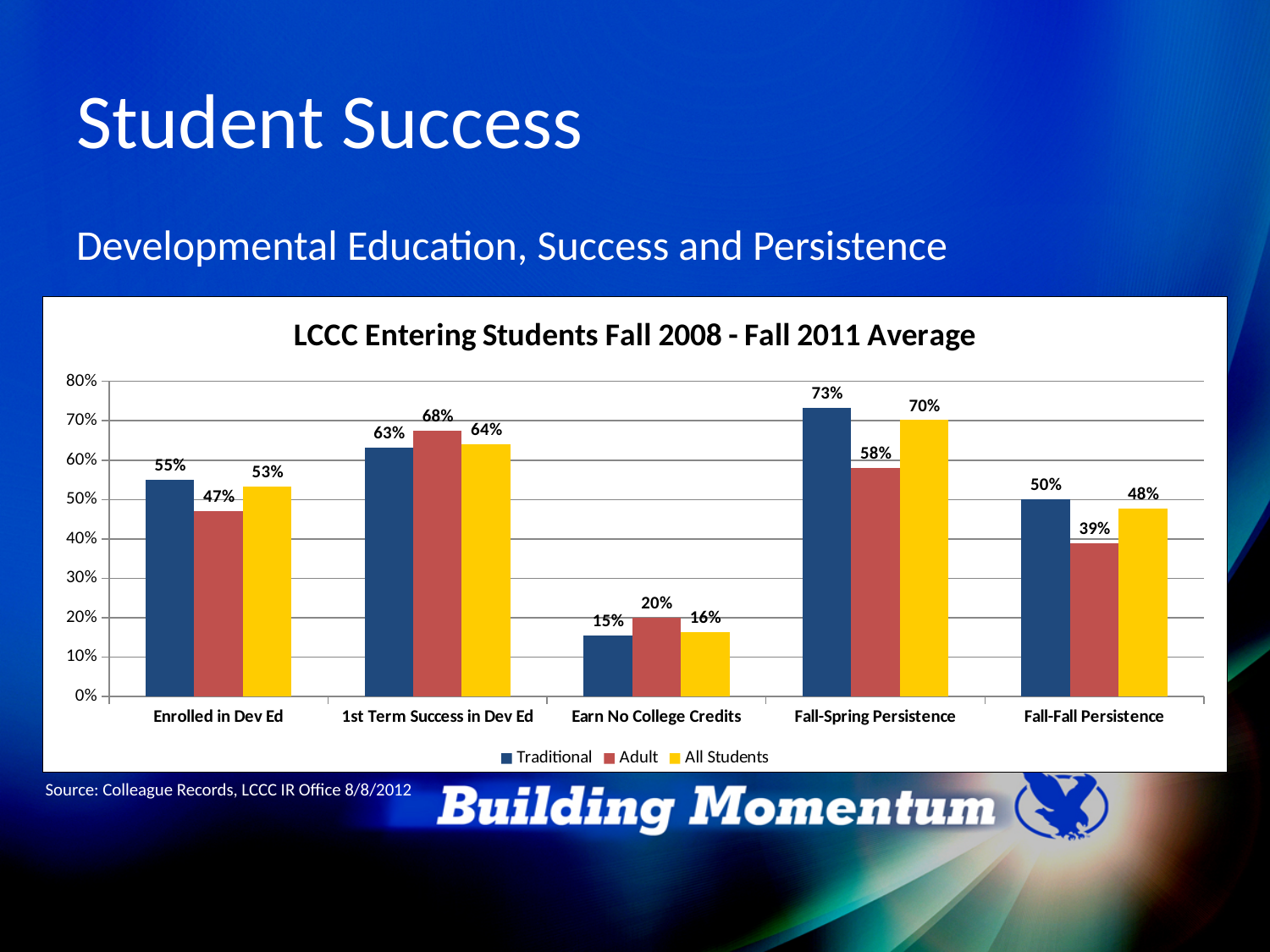
What is the All Students value for Fall-Fall Persistence? 48% What is the Traditional value for Fall-Spring Persistence? 73% What is the title of the chart? LCCC Entering Students Fall 2008 - Fall 2011 Average How many categories are shown on the x axis? 5 How many series does the legend list? 3 What is the difference between the Traditional and Adult values for Fall-Spring Persistence? 15% Which is larger for 1st Term Success in Dev Ed: the Traditional value or the Adult value? Adult Which category has the highest Traditional value? Fall-Spring Persistence Which category has the lowest Adult value? Earn No College Credits What kind of chart is shown on the slide? Bar chart What is the Adult value for Enrolled in Dev Ed? 47% Which series is shown in yellow in the legend? All Students